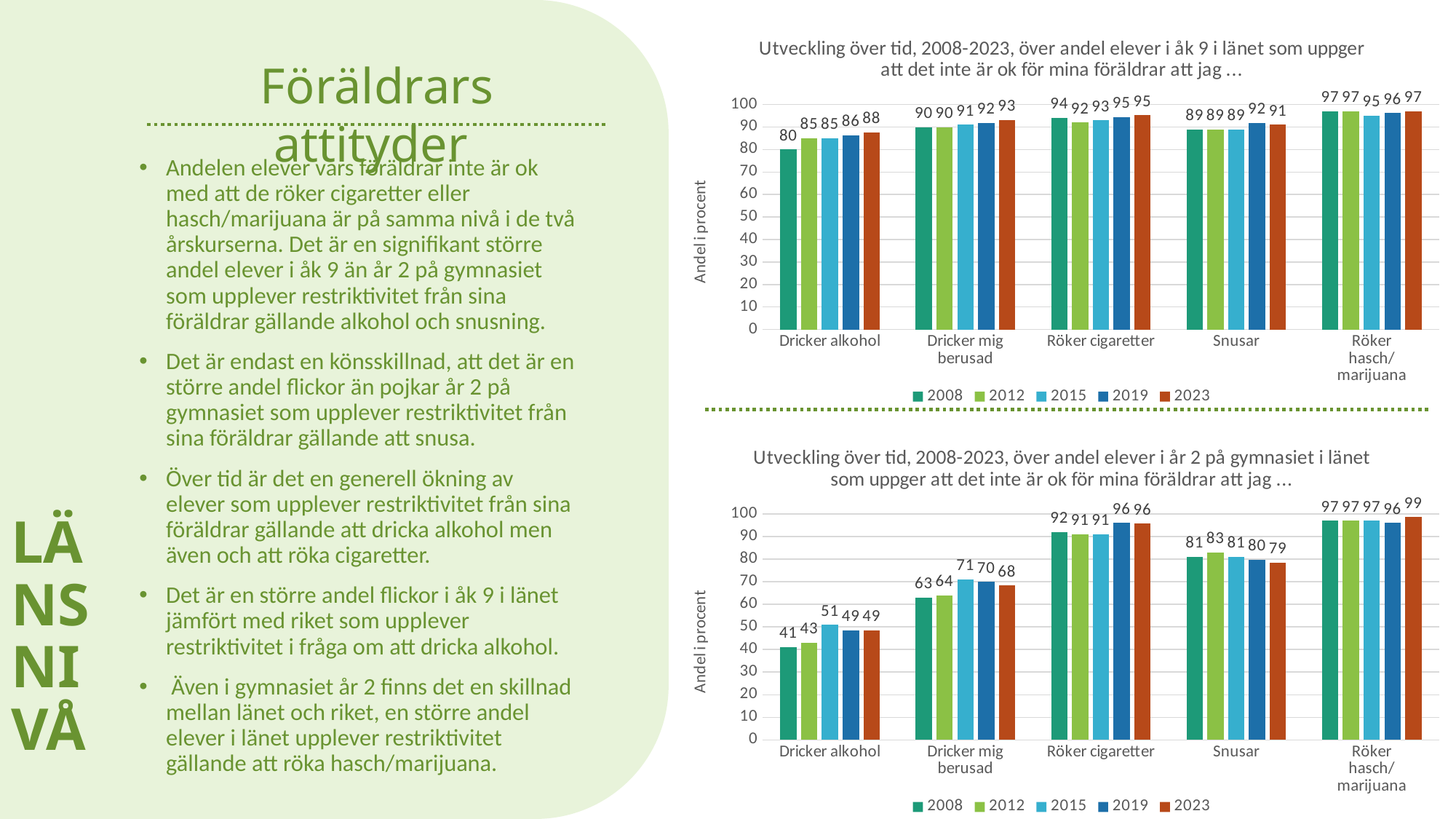
In the bottom chart (år 2 på gymnasiet), what is the value for Dricker mig berusad in 2015? 71 How many series does the legend of the top chart list? 5 In the top chart (åk 9), which category has the highest value for 2023? Röker hasch/marijuana In the top chart (åk 9), what is the difference between the 2023 and 2008 values for Dricker alkohol? 8 In the bottom chart (år 2 på gymnasiet), which is larger for Snusar: the 2012 value or the 2023 value? 2012 In the bottom chart (år 2 på gymnasiet), what is the value for Röker hasch/marijuana in 2023? 99 In the bottom chart (år 2 på gymnasiet), what is the difference between the 2015 and 2008 values for Dricker alkohol? 10 In the bottom chart (år 2 på gymnasiet), which category has the lowest value for 2008? Dricker alkohol What type of chart is the top chart? Bar chart In the top chart (åk 9), what is the value for Snusar in 2019? 92 In the top chart (åk 9), what is the value for Dricker alkohol in 2008? 80 How many categories are shown on the x axis of the bottom chart? 5